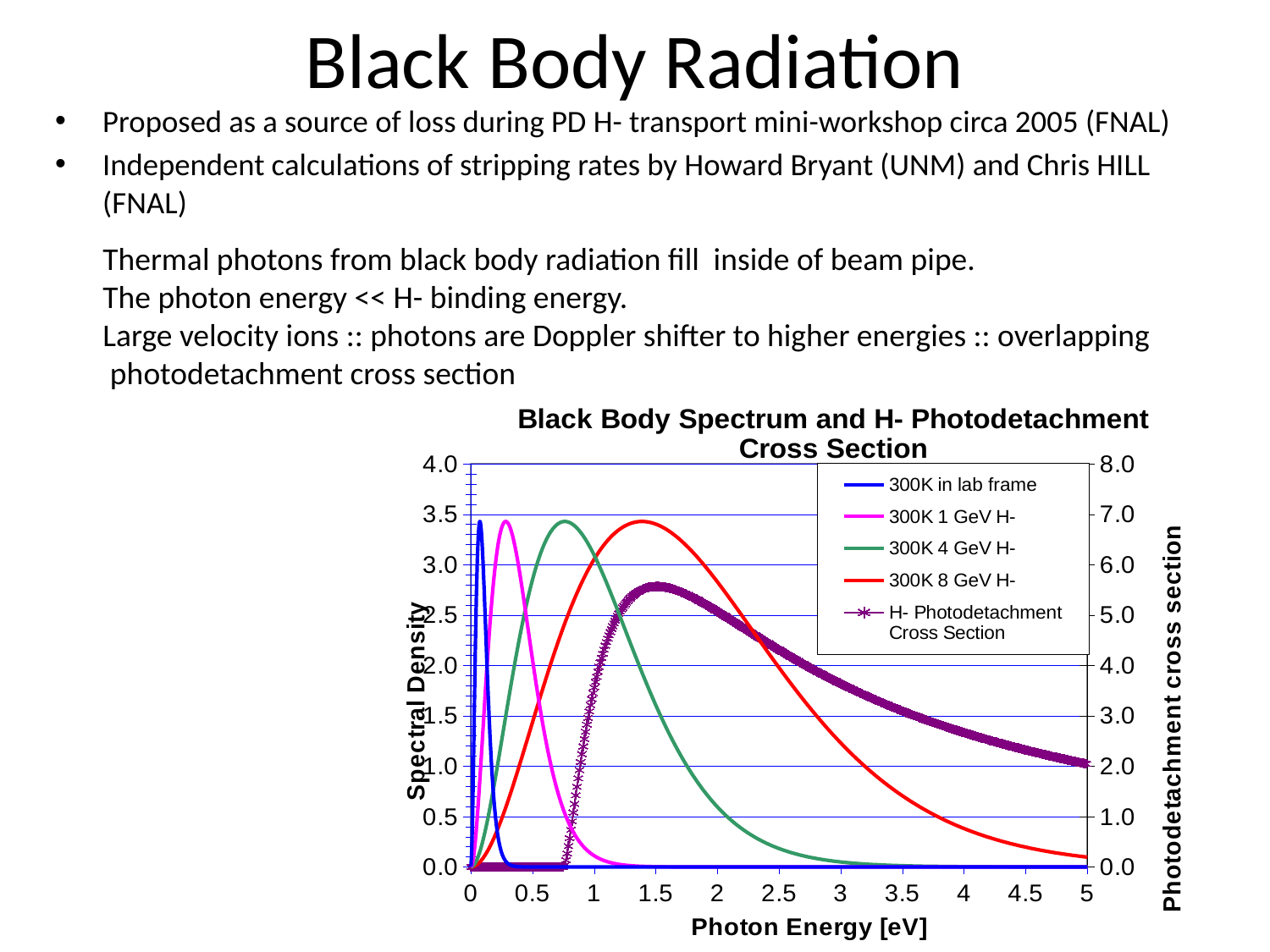
What kind of chart is shown on the slide? line chart What is the label of the x axis of the chart? Photon Energy [eV] Which of the black body spectrum series peaks at the highest photon energy? 300K 8 GeV H- Which series peaks at a higher photon energy, 300K 1 GeV H- or 300K 4 GeV H-? 300K 4 GeV H- Is the H- Photodetachment Cross Section value at 3 eV greater or less than 3.0 on the right axis? greater What is the title of the chart? Black Body Spectrum and H- Photodetachment Cross Section Is the peak spectral density of the 300K 8 GeV H- curve greater or less than 3.0? greater Is the spectral density of the 300K 8 GeV H- curve at 5 eV greater or less than 0.5? less After reaching its peak, does the H- Photodetachment Cross Section curve rise or fall as photon energy increases? fall How many series does the chart legend list? 5 Which series peaks at the lowest photon energy? 300K in lab frame